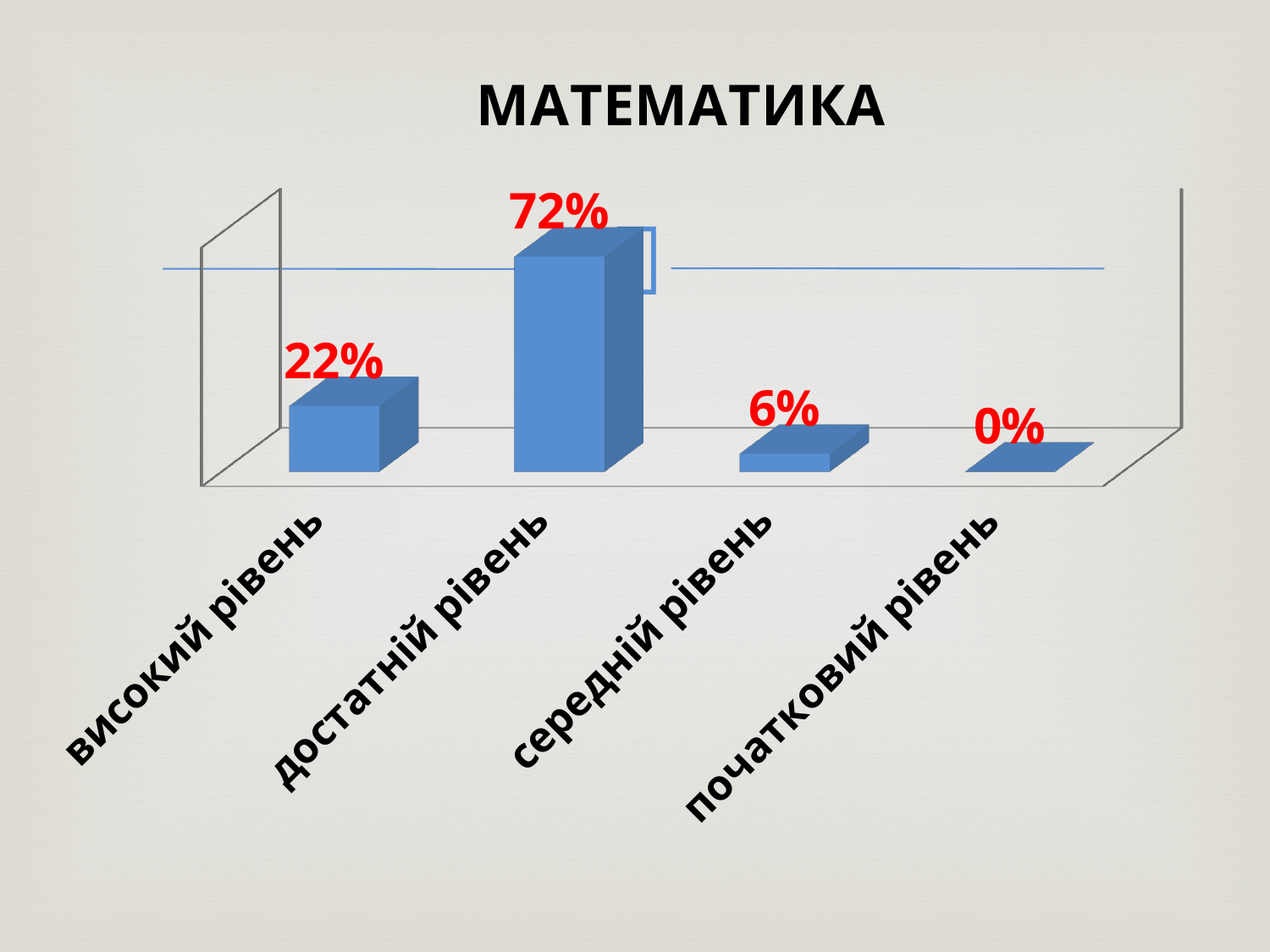
What is the difference between the values for високий рівень and середній рівень? 16% What is the title of the chart? МАТЕМАТИКА What is the value for високий рівень? 22% What kind of chart is shown on the slide? bar chart What is the difference between the values for достатній рівень and високий рівень? 50% What is the value for середній рівень? 6% How many categories are shown on the chart? 4 Which is larger, the value for високий рівень or the value for середній рівень? високий рівень What is the value for достатній рівень? 72% Which category has the lowest value? початковий рівень What is the value for початковий рівень? 0% Which category has the highest value? достатній рівень